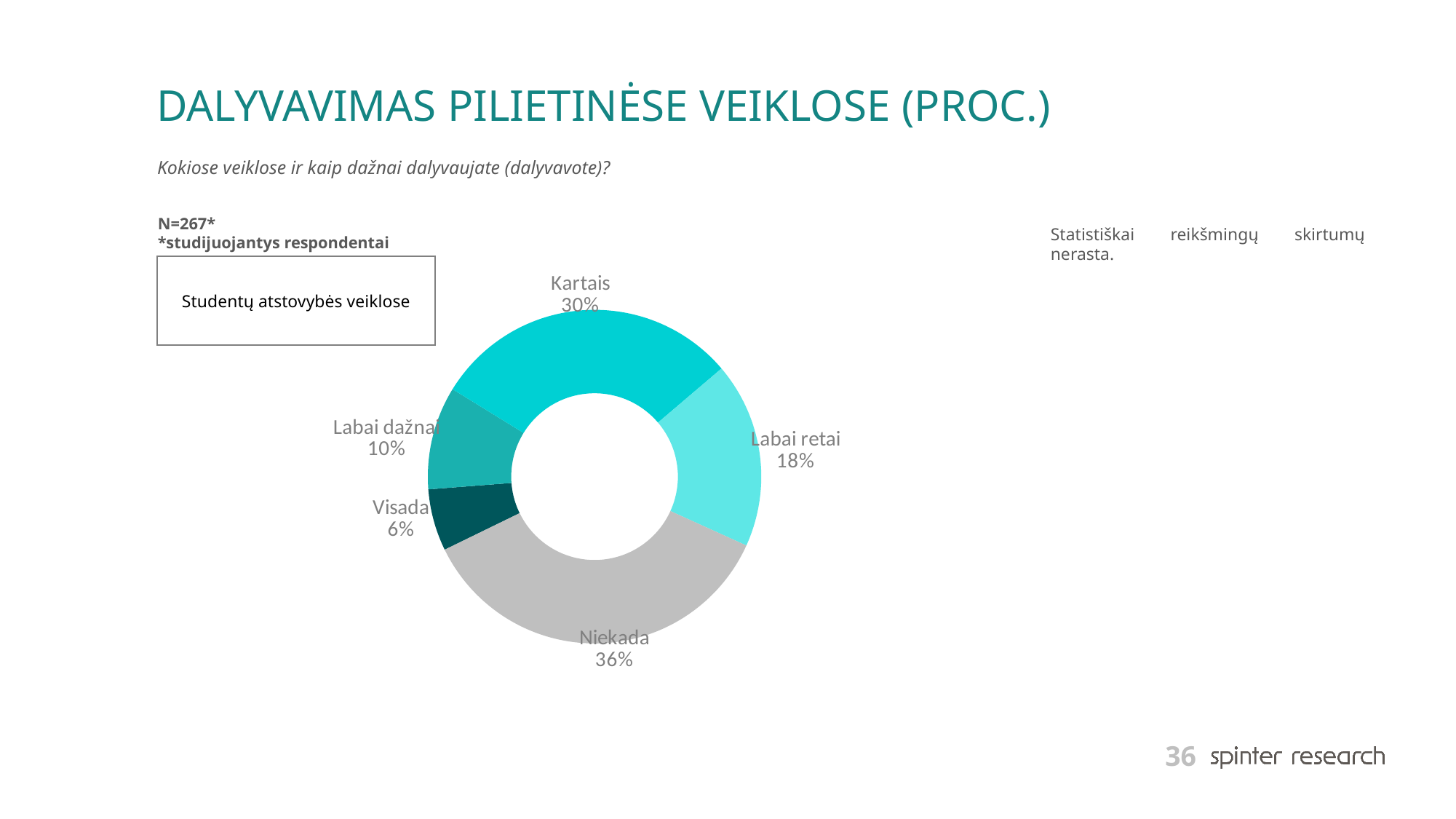
What type of chart is shown on the slide? Pie chart (doughnut) What share is shown for 'Kartais'? 30% What is the value for 'Labai retai'? 18% Which is larger, 'Labai retai' or 'Labai dažnai'? Labai retai Which category has the largest share in the chart? Niekada What is the value for 'Visada'? 6% Which category has the smallest share in the chart? Visada What percentage of respondents answered 'Niekada' in the Studentų atstovybės veiklose chart? 36% What percentage is shown for 'Labai dažnai'? 10% What is the sample size (N) stated on the slide? N=267* How many categories are shown in the chart? 5 What is the difference in percentage points between 'Niekada' and 'Kartais'? 6